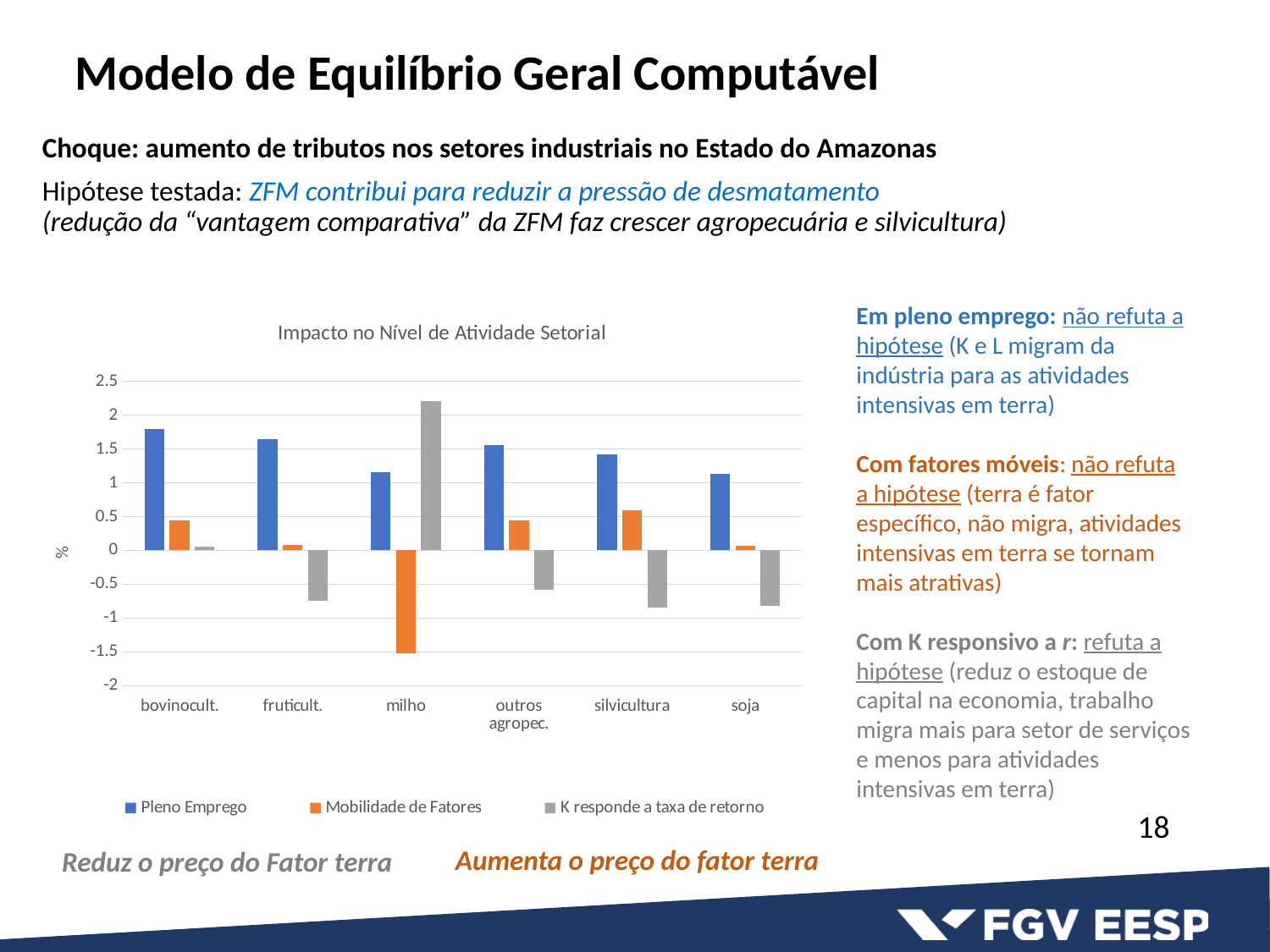
Is the Mobilidade de Fatores value for milho greater or less than -1? less How many series does the chart legend list? 3 Which category has the tallest bar in the whole chart? milho For milho, which series has the larger value: Pleno Emprego or K responde a taxa de retorno? K responde a taxa de retorno What is the label on the vertical axis of the chart? % Is the K responde a taxa de retorno value for milho greater or less than 2? greater Is the Pleno Emprego value for bovinocult. greater or less than 1.5? greater Which category has the highest value for the Pleno Emprego series? bovinocult. Which category has the lowest (most negative) bar in the whole chart? milho How many categories are shown on the x axis of the chart? 6 What kind of chart is shown on the slide? bar chart What is the title of the chart? Impacto no Nível de Atividade Setorial